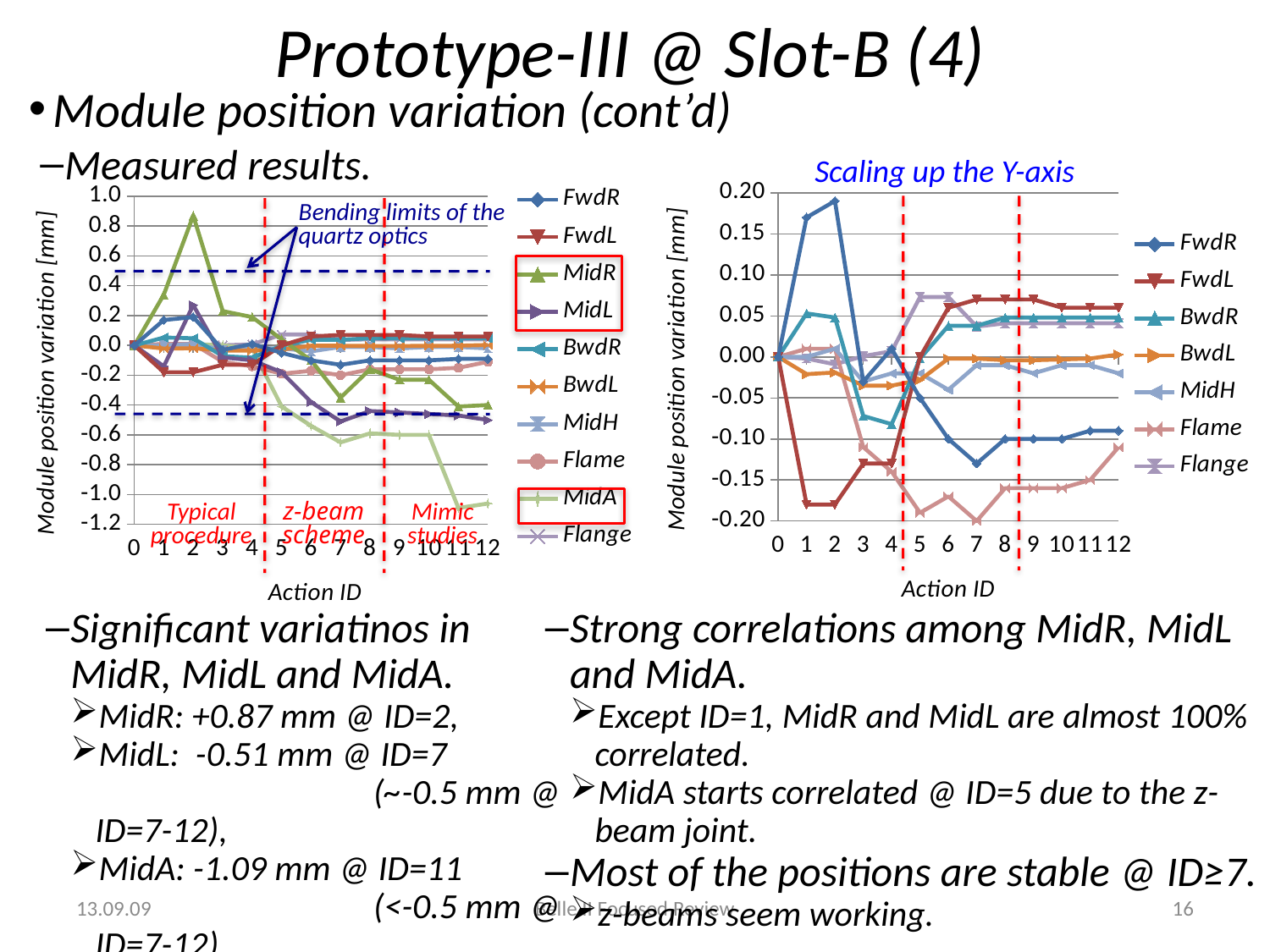
In the right chart, which is larger at Action ID 2: FwdR or FwdL? FwdR What is the title shown above the right chart? Scaling up the Y-axis In the left chart, how many Action ID points are plotted along the x axis? 13 In the right chart, is the value of FwdR at Action ID 2 greater or less than 0.15? greater How many series does the legend of the right chart list? 7 What kind of chart is the left chart on the slide? line chart In the left chart, is the value of MidA at Action ID 11 greater or less than -1.0? less In the right chart, is the value of FwdL at Action ID 1 greater or less than -0.15? less How many series does the legend of the left chart list? 10 In the left chart, which series reaches the lowest value? MidA In the left chart, which series reaches the highest value? MidR